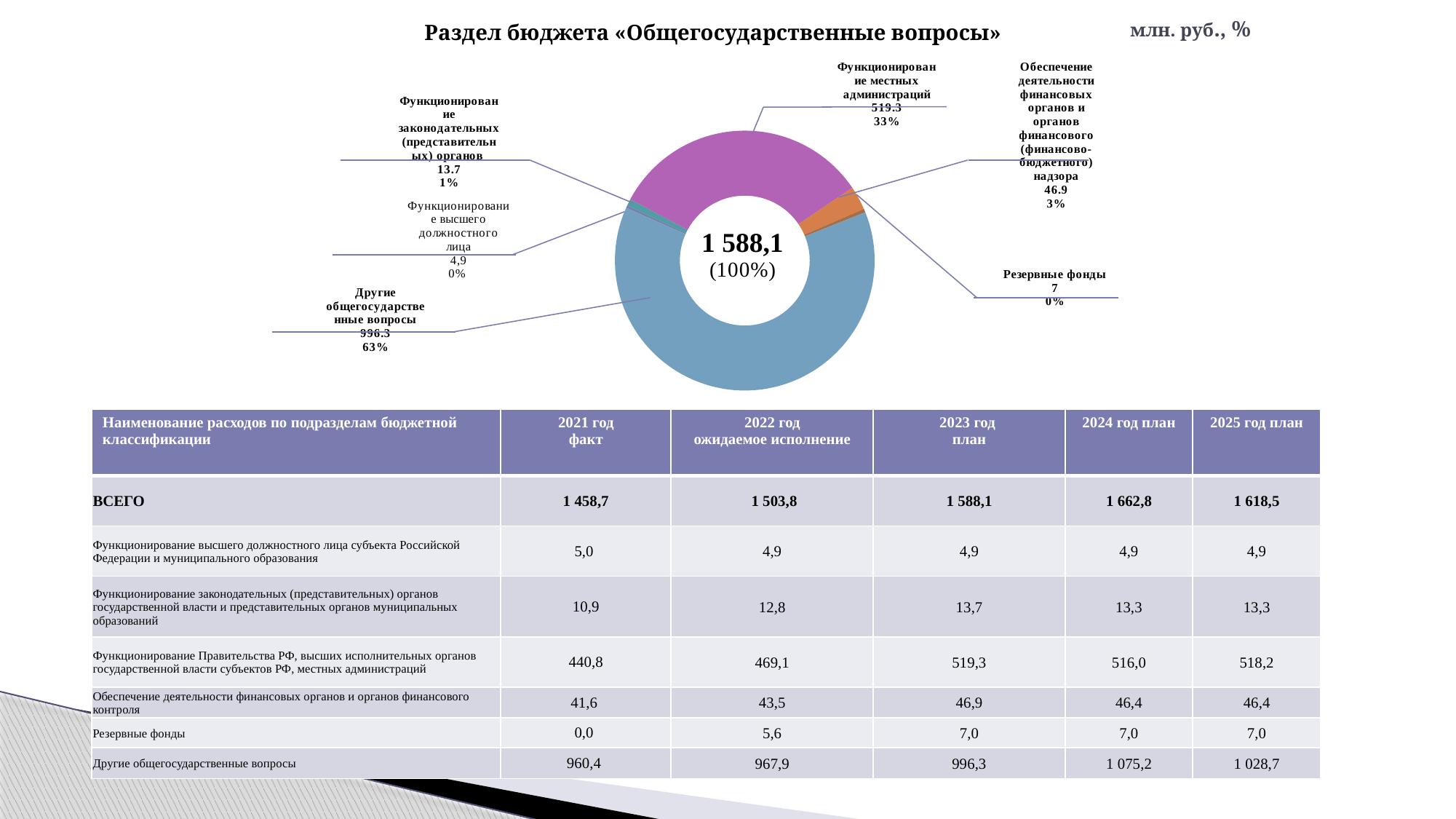
What value is shown for «Обеспечение деятельности финансовых органов и органов финансового (финансово-бюджетного) надзора» in the donut chart? 46.9 What share of the donut chart does «Функционирование местных администраций» take? 33% How many categories are shown in the donut chart? 6 What share of the donut chart does «Другие общегосударственные вопросы» take? 63% What value is shown for «Резервные фонды» in the donut chart? 7 What kind of chart is shown on the slide? Pie chart (donut) What value is shown for «Другие общегосударственные вопросы» in the donut chart? 996.3 What value is shown for «Функционирование местных администраций» in the donut chart? 519.3 Which is larger in the donut chart: «Функционирование местных администраций» or «Обеспечение деятельности финансовых органов»? Функционирование местных администраций Which category has the smallest value in the donut chart? Функционирование высшего должностного лица What total value is shown in the centre of the donut chart? 1 588,1 Which category has the largest slice in the donut chart? Другие общегосударственные вопросы